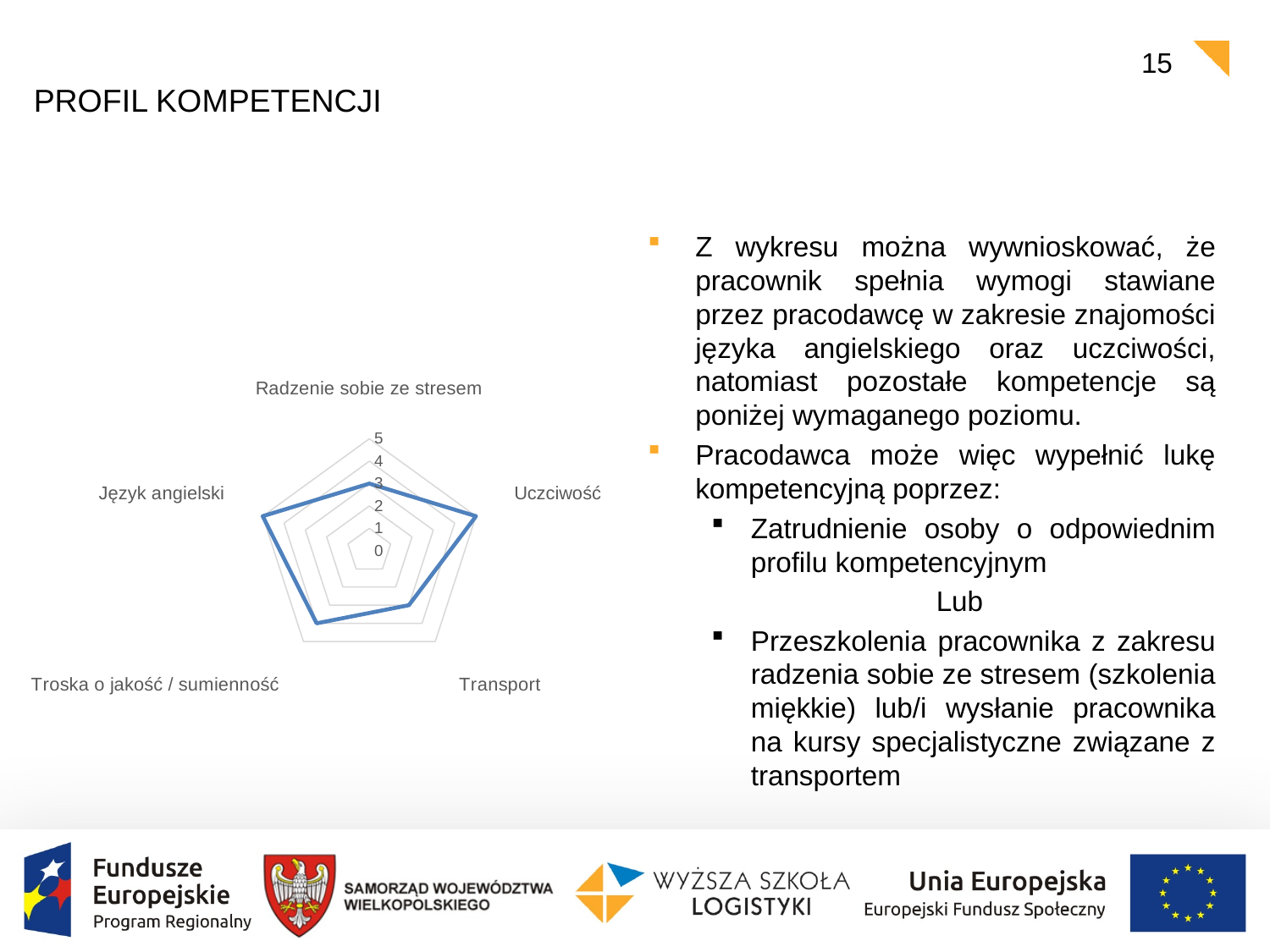
What is the maximum value shown on the chart's scale? 5 Which category has the lowest value on the chart? Radzenie sobie ze stresem and Transport (both 3) What kind of chart is shown on the slide? radar chart Which is larger, the value for Uczciwość or the value for Radzenie sobie ze stresem? Uczciwość Is the value for Troska o jakość / sumienność greater or less than 3? greater Which category label appears at the top of the radar chart? Radzenie sobie ze stresem Is the value for Uczciwość greater or less than 4? greater Is the value for Radzenie sobie ze stresem greater or less than 4? less How many competency categories (axes) does the chart have? 5